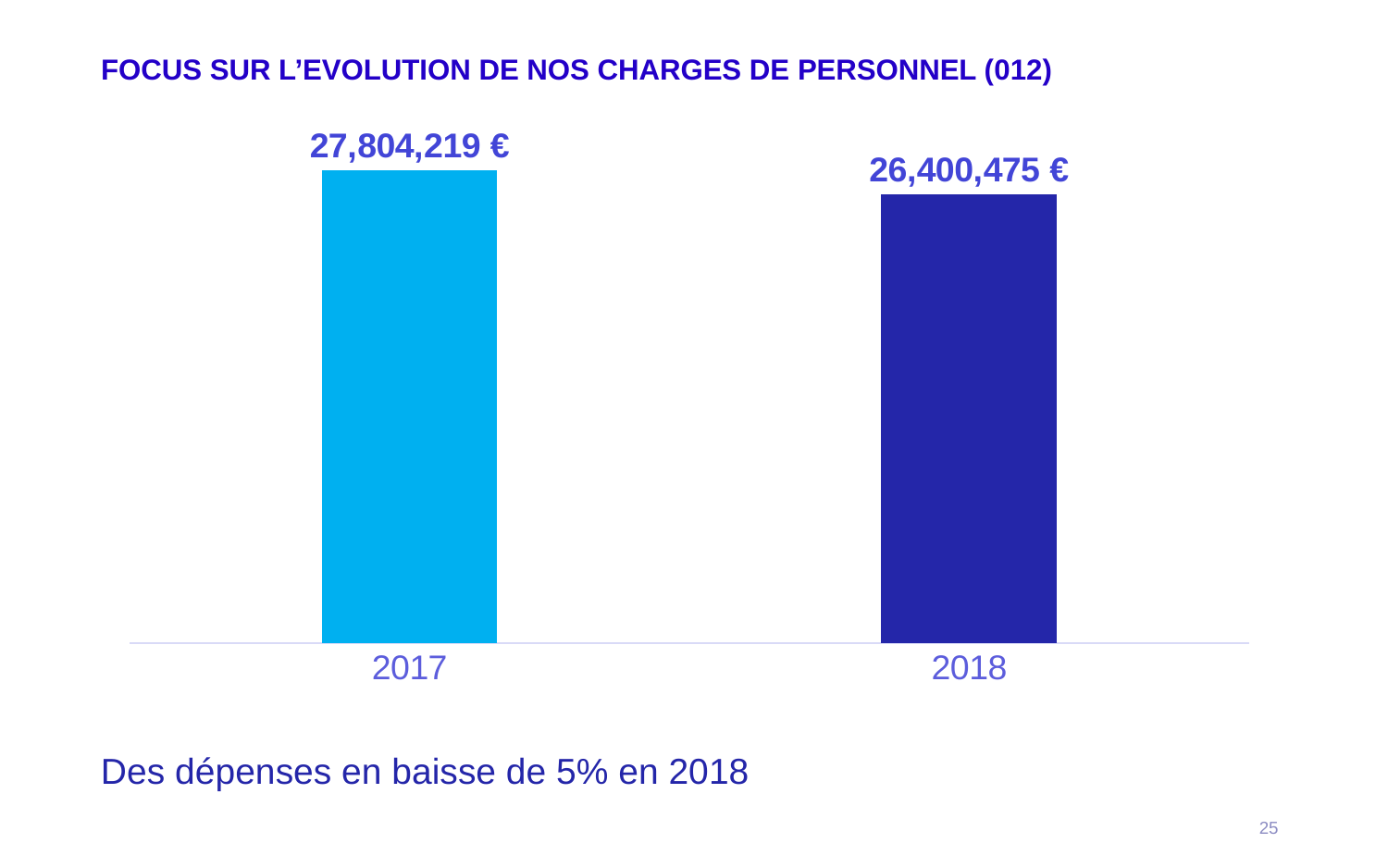
What is the difference between the 2017 and 2018 values? 1,403,744 € How many categories are shown on the x axis? 2 Which year has the highest value? 2017 What is the value for 2017? 27,804,219 € What kind of chart is shown on the slide? Bar chart Do the values rise or fall from 2017 to 2018? Fall Which is larger, the value for 2017 or the value for 2018? 2017 What is the title of the chart? FOCUS SUR L'EVOLUTION DE NOS CHARGES DE PERSONNEL (012) What is the value for 2018? 26,400,475 € Which year has the lowest value? 2018 According to the text below the chart, by what percentage did expenses decrease in 2018? 5%